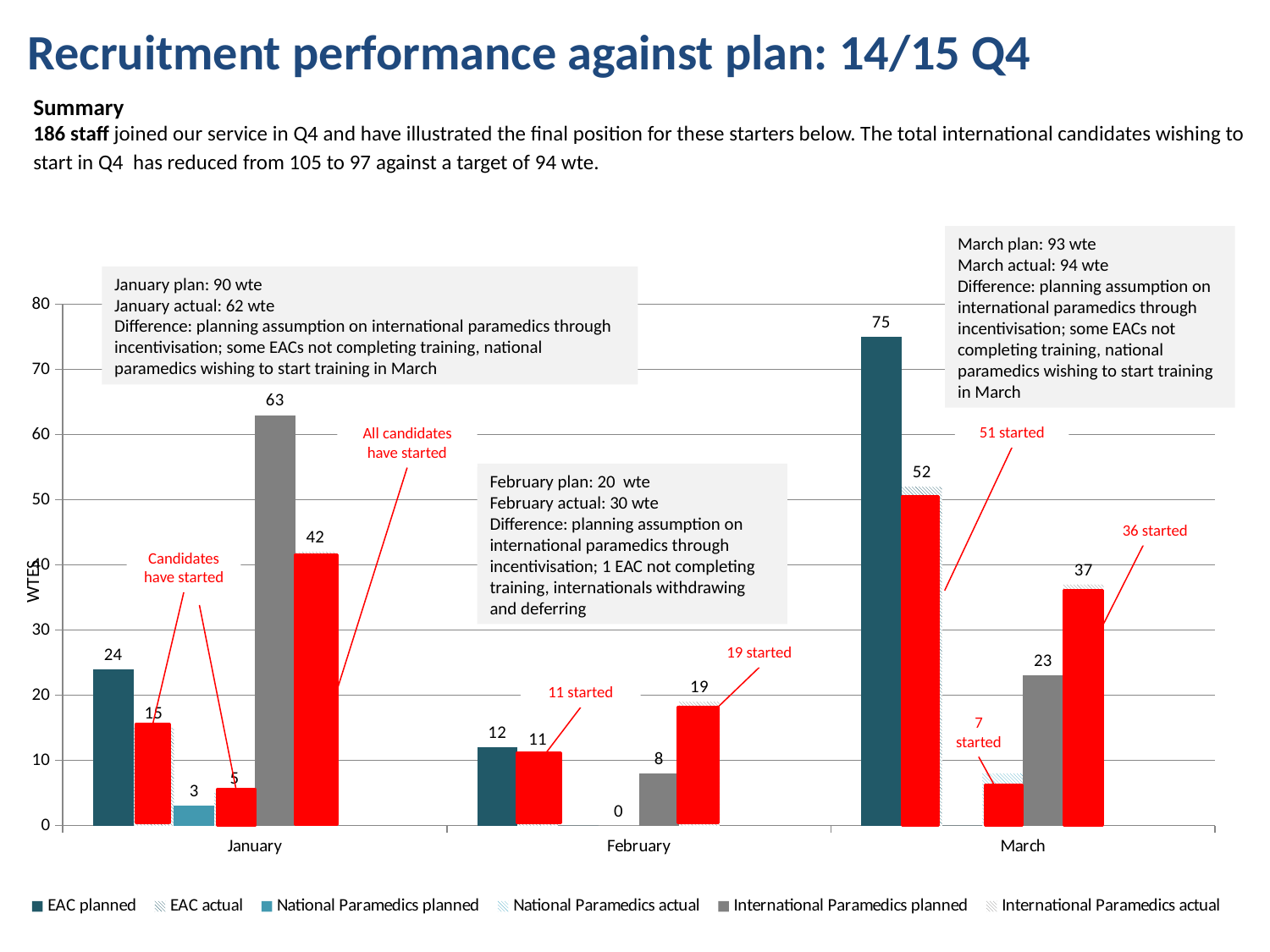
How many months are shown on the x axis of the chart? 3 What is the value for EAC planned in January? 24 What is the value for EAC planned in March? 75 In which month is the EAC planned value highest? March What is the value for International Paramedics planned in January? 63 What is the value for International Paramedics actual in March? 37 Is the value for National Paramedics actual in March greater or less than 10? less What is the difference between International Paramedics planned and International Paramedics actual in January? 21 In February, which is larger: International Paramedics planned or International Paramedics actual? International Paramedics actual What kind of chart is shown on the slide? bar chart How many series does the legend list? 6 What is the difference between EAC planned and EAC actual in March? 23